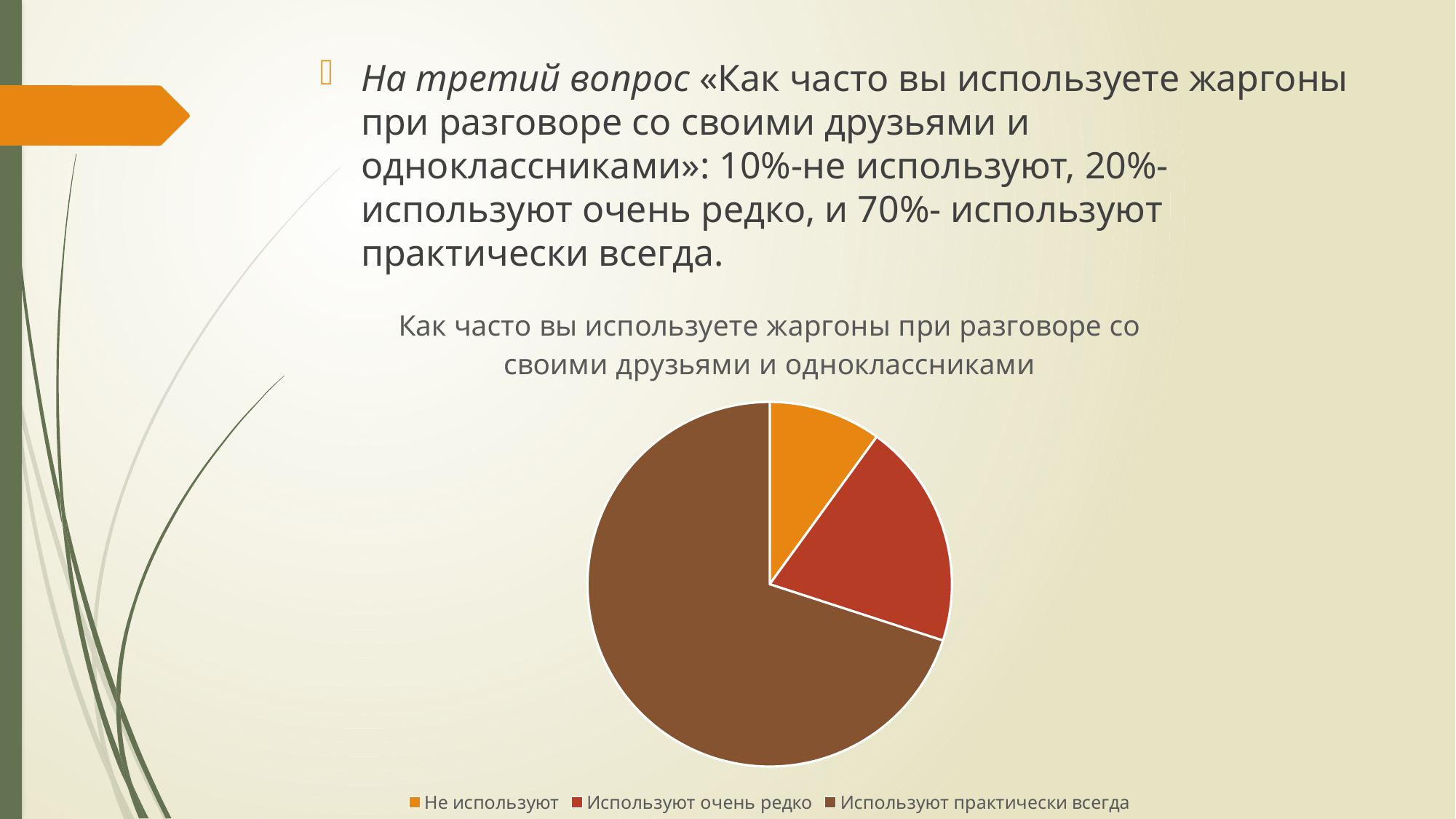
Which slice is larger: 'Не используют' or 'Используют очень редко'? Используют очень редко What share of the pie does 'Не используют' represent? 10% What share of the pie does 'Используют очень редко' represent? 20% What is the difference between the shares of 'Используют практически всегда' and 'Используют очень редко'? 50% What share of the pie does 'Используют практически всегда' represent? 70% How many entries does the legend of the pie chart list? 3 Which colour represents 'Не используют' in the pie chart? orange Which category has the largest slice in the pie chart? Используют практически всегда What is the title of the pie chart? Как часто вы используете жаргоны при разговоре со своими друзьями и одноклассниками What kind of chart is shown on the slide? pie chart Which category has the smallest slice in the pie chart? Не используют How many slices does the pie chart have? 3